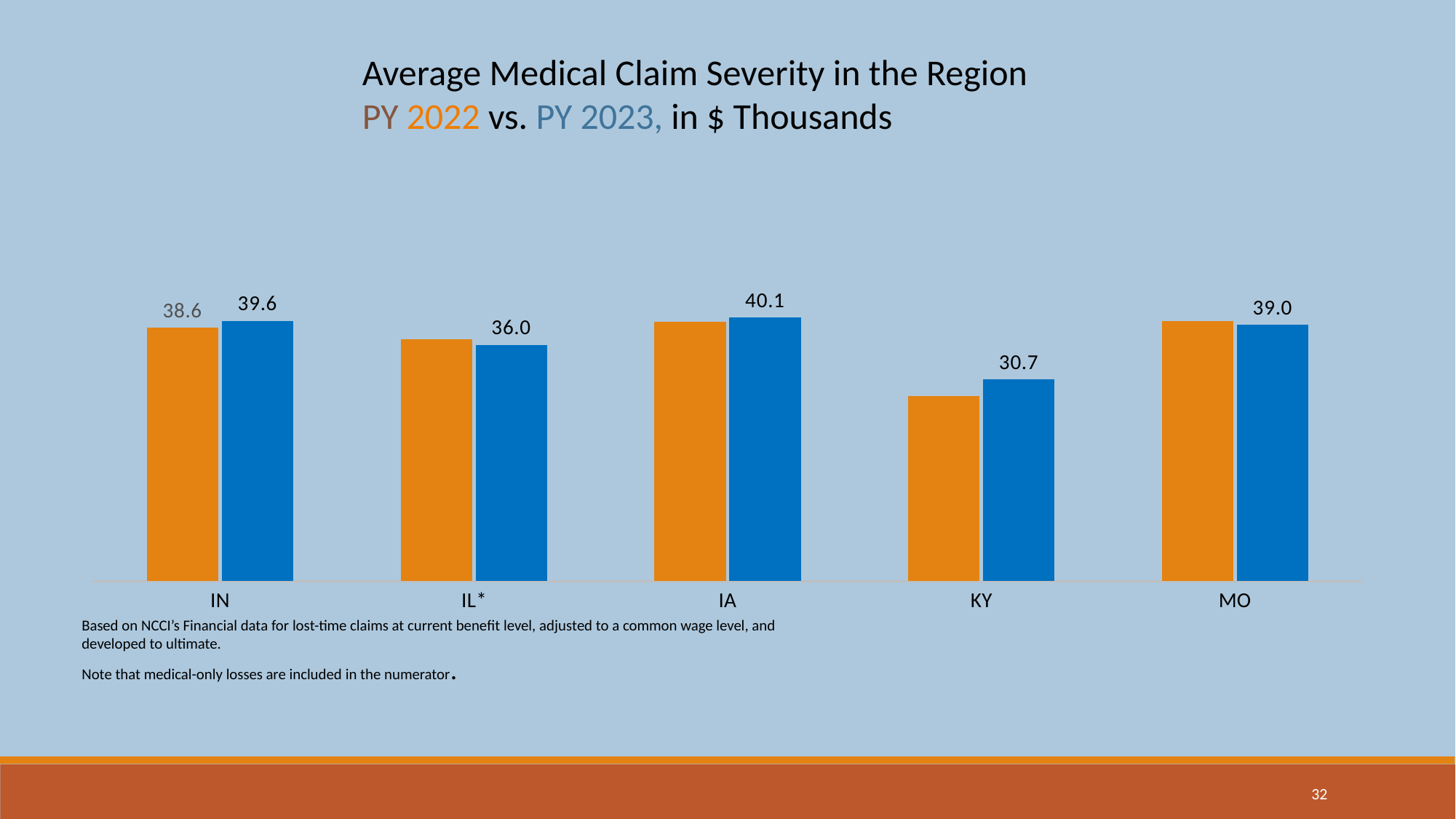
What is the PY 2023 value for IA? 40.1 What is the PY 2023 value for KY? 30.7 By how much did IN's average medical claim severity change from PY 2022 to PY 2023? 1.0 How many states are shown on the chart? 5 What is the PY 2022 average medical claim severity for IN? 38.6 Which has the larger PY 2022 value, KY or MO? MO What is the difference between the PY 2023 values for IA and KY? 9.4 What is the PY 2023 value for MO? 39.0 Which state has the lowest PY 2023 average medical claim severity? KY What is the PY 2023 average medical claim severity for IN? 39.6 Which state has the highest PY 2023 average medical claim severity? IA What is the PY 2023 value for IL*? 36.0